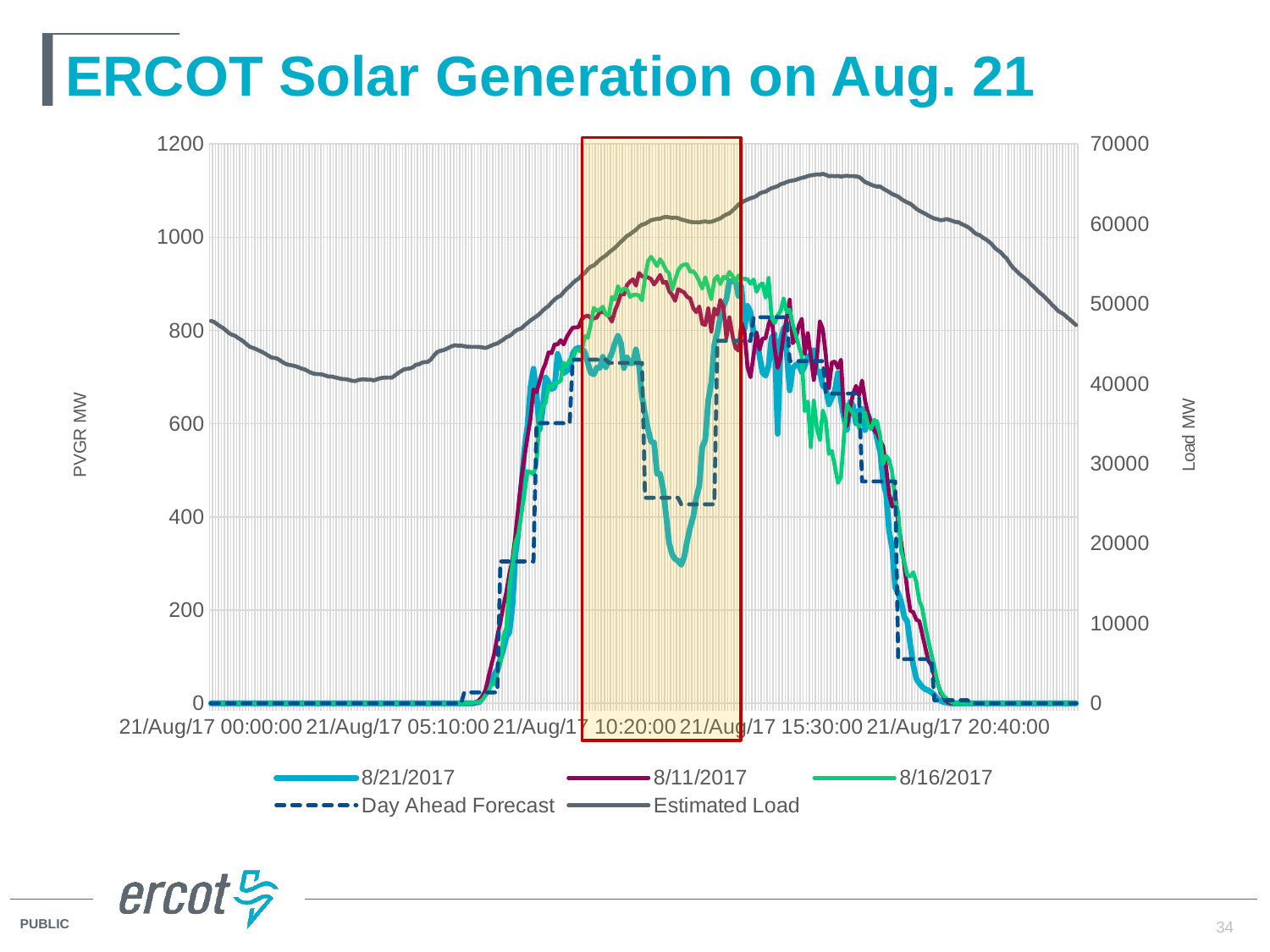
Is the peak value of the 8/16/2017 series greater or less than 1000? less Is the peak value of the Estimated Load series greater or less than 60000? greater What is the value of the 8/21/2017 series at 21/Aug/17 00:00:00? 0 What is the label of the left vertical axis? PVGR MW Is the Day Ahead Forecast value during its dip inside the highlighted box greater or less than 600? less Does the Estimated Load series rise or fall between 21/Aug/17 00:00:00 and 21/Aug/17 05:10:00? fall How many series does the legend list? 5 What is the title of the chart? ERCOT Solar Generation on Aug. 21 What kind of chart is shown on the slide? line chart Inside the highlighted red box, which series drops lower: 8/21/2017 or 8/11/2017? 8/21/2017